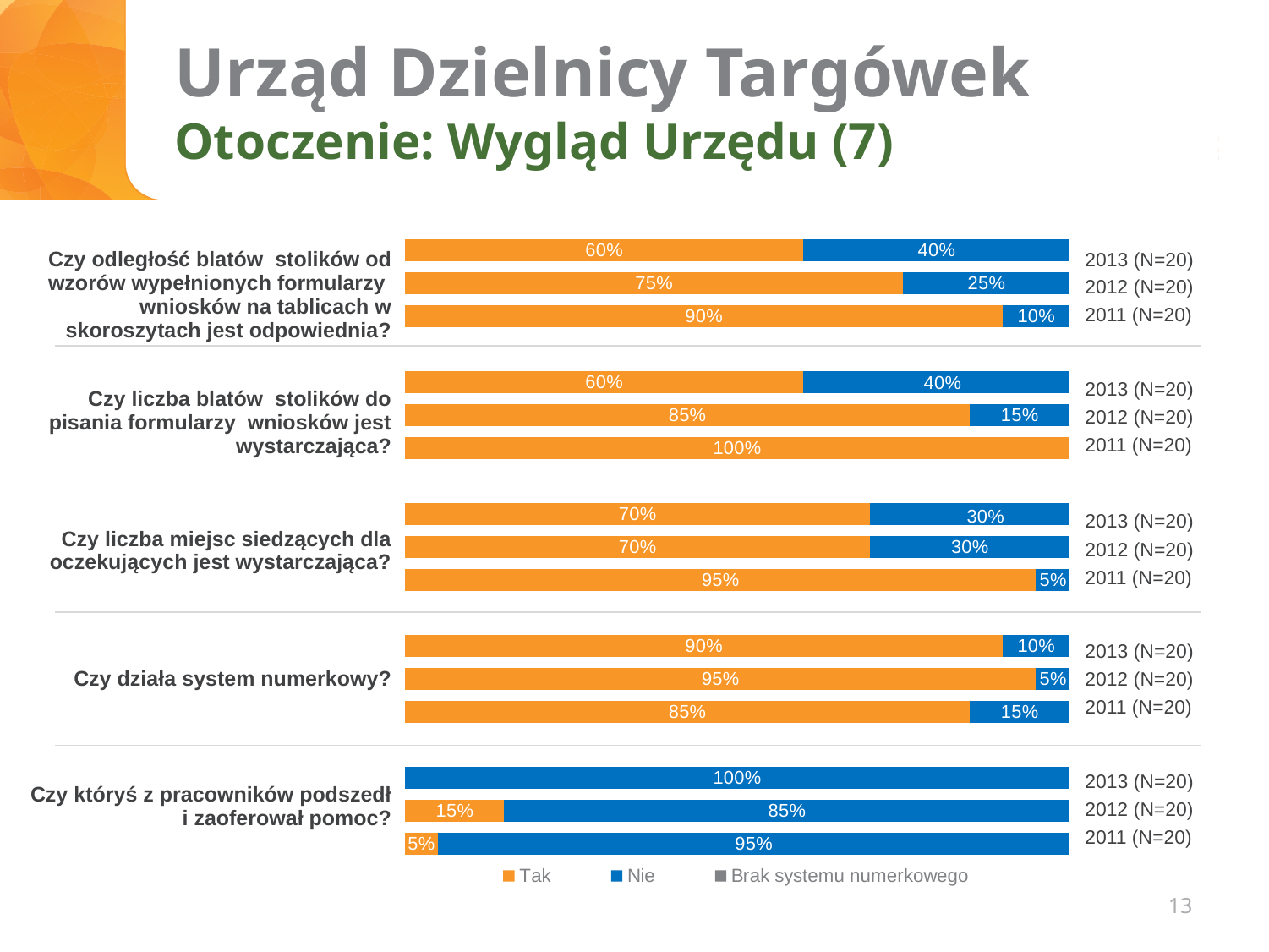
What percentage answered "Tak" in 2013 to "Czy odległość blatów stolików od wzorów wypełnionych formularzy wniosków na tablicach w skoroszytach jest odpowiednia?"? 60% For "Czy działa system numerkowy?", what is the difference between the "Tak" share in 2012 and in 2011? 10% How many series does the legend list? 3 For "Czy działa system numerkowy?", which year has the highest "Tak" share? 2012 (N=20) What kind of chart is shown on the slide? Stacked bar chart What percentage answered "Nie" in 2012 to "Czy liczba blatów stolików do pisania formularzy wniosków jest wystarczająca?"? 15% For "Czy odległość blatów stolików od wzorów wypełnionych formularzy wniosków na tablicach w skoroszytach jest odpowiednia?", does the "Tak" share rise or fall from 2011 to 2013? Fall What percentage answered "Tak" in 2011 to "Czy liczba miejsc siedzących dla oczekujących jest wystarczająca?"? 95% For "Czy któryś z pracowników podszedł i zaoferował pomoc?", is the "Tak" share larger in 2012 or in 2011? 2012 Which colour represents the "Nie" answers in the chart? Blue For "Czy odległość blatów stolików od wzorów wypełnionych formularzy wniosków na tablicach w skoroszytach jest odpowiednia?", which year has the lowest "Tak" share? 2013 (N=20) What percentage answered "Nie" in 2013 to "Czy któryś z pracowników podszedł i zaoferował pomoc?"? 100%